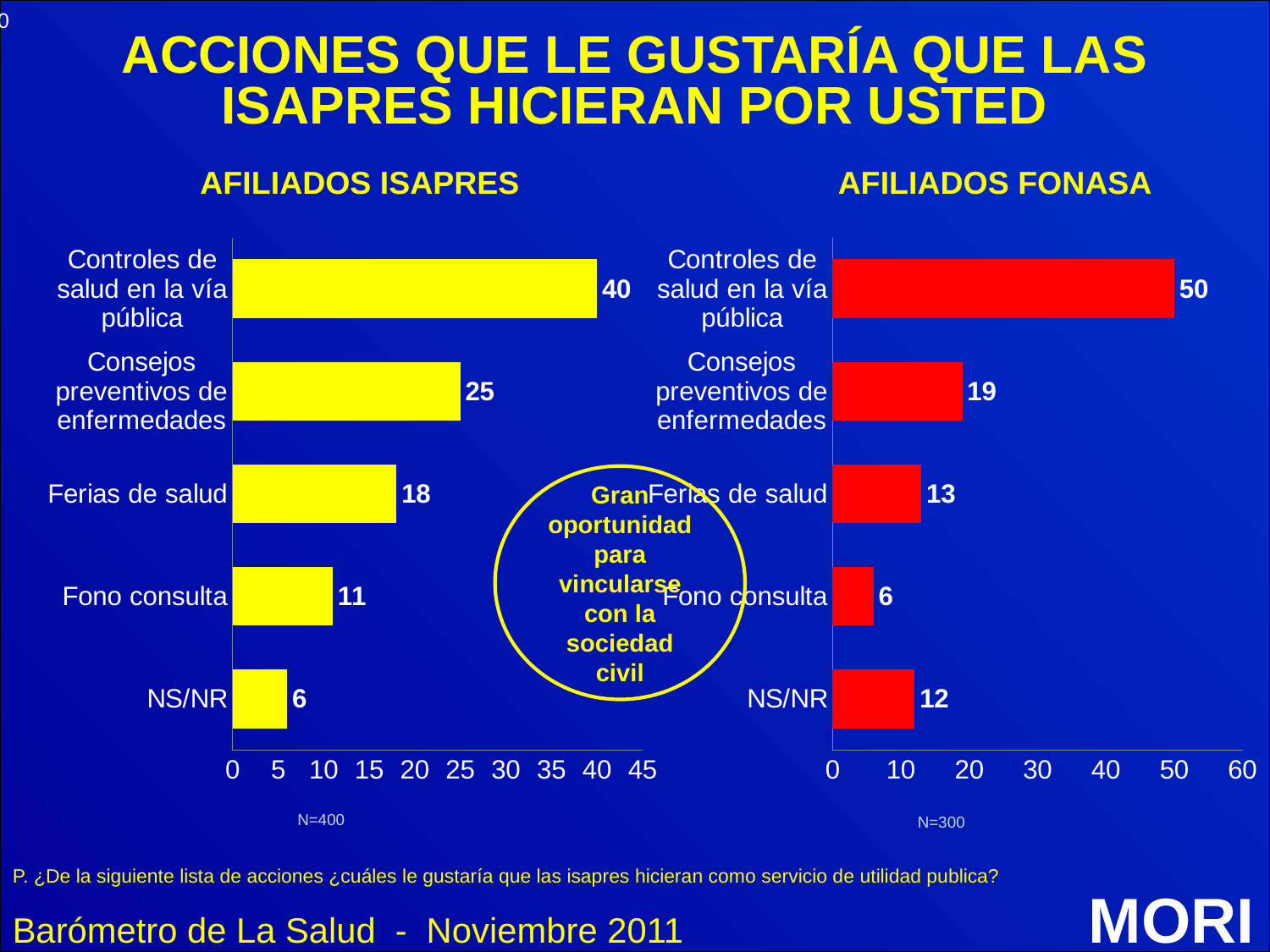
What type of chart is the AFILIADOS FONASA chart? Bar chart In the AFILIADOS FONASA chart, what is the difference between Ferias de salud and Fono consulta? 7 In the AFILIADOS ISAPRES chart, which category has the highest value? Controles de salud en la vía pública In the AFILIADOS FONASA chart, what is the value for NS/NR? 12 In the AFILIADOS FONASA chart, which category has the lowest value? Fono consulta In the AFILIADOS FONASA chart, is the value for Controles de salud en la vía pública greater or less than 40? greater In the AFILIADOS FONASA chart, what is the value for Consejos preventivos de enfermedades? 19 In the AFILIADOS ISAPRES chart, what is the value for Controles de salud en la vía pública? 40 In the AFILIADOS ISAPRES chart, what is the difference between Controles de salud en la vía pública and Consejos preventivos de enfermedades? 15 Which is larger: Ferias de salud in the AFILIADOS ISAPRES chart or Ferias de salud in the AFILIADOS FONASA chart? AFILIADOS ISAPRES What colour are the bars in the AFILIADOS ISAPRES chart? Yellow How many categories are shown in the AFILIADOS ISAPRES chart? 5